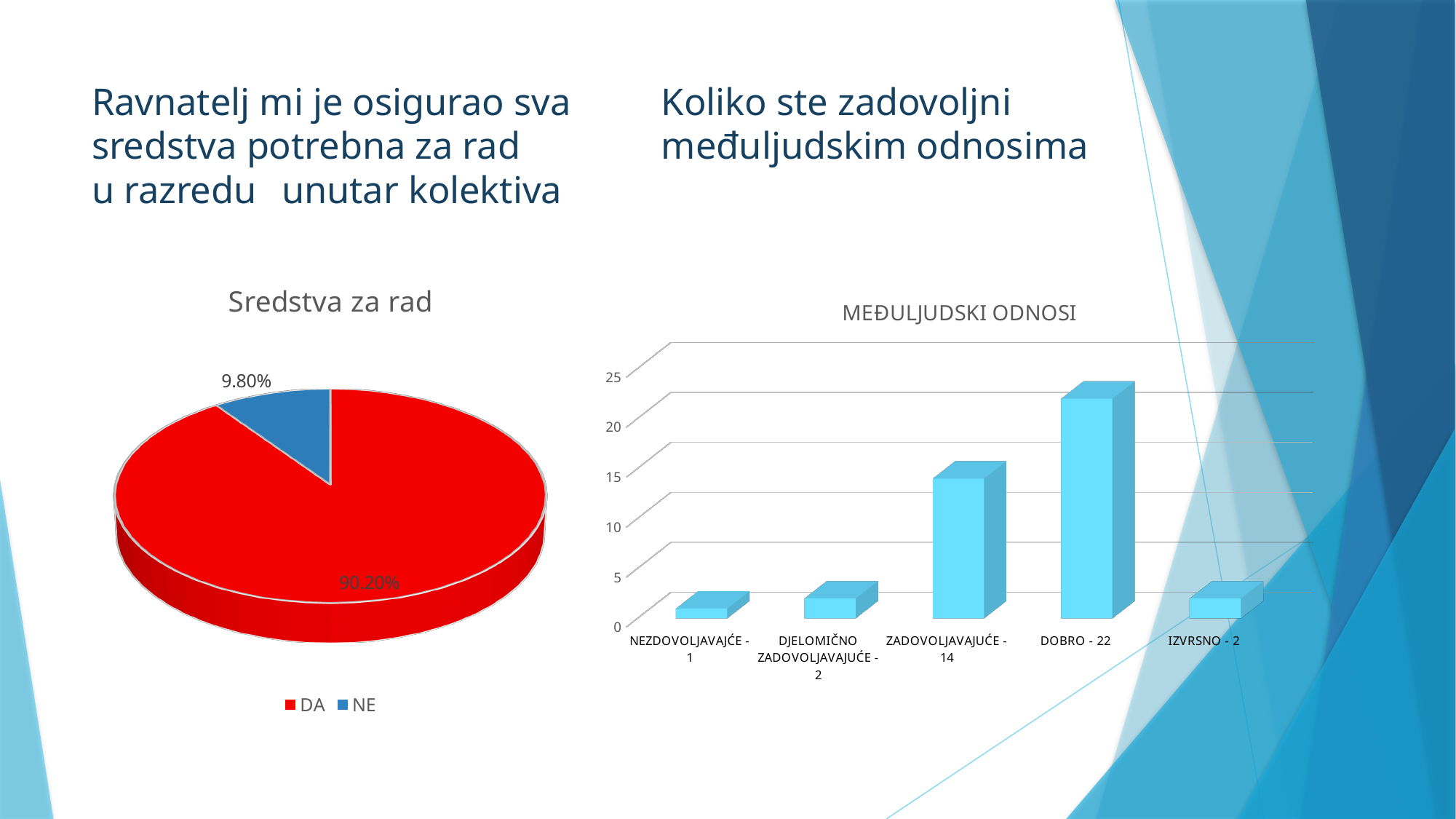
What kind of chart is 'MEĐULJUDSKI ODNOSI'? bar chart How many categories are shown in the 'MEĐULJUDSKI ODNOSI' chart? 5 In the 'MEĐULJUDSKI ODNOSI' chart, which category has the highest value? DOBRO In the 'MEĐULJUDSKI ODNOSI' chart, is the value for DOBRO greater or less than 20? greater In the 'Sredstva za rad' chart, what percentage is shown for NE? 9.80% How many entries does the legend of the 'Sredstva za rad' chart list? 2 In the 'Sredstva za rad' chart, what percentage is shown for DA? 90.20% What kind of chart is 'Sredstva za rad'? pie chart In the 'Sredstva za rad' chart, which slice is larger, DA or NE? DA In the 'MEĐULJUDSKI ODNOSI' chart, what is the difference between the values for DOBRO and ZADOVOLJAVAJUĆE? 8 In the 'MEĐULJUDSKI ODNOSI' chart, which category has the lowest value? NEZDOVOLJAVAJĆE In the 'MEĐULJUDSKI ODNOSI' chart, what is the value for ZADOVOLJAVAJUĆE? 14